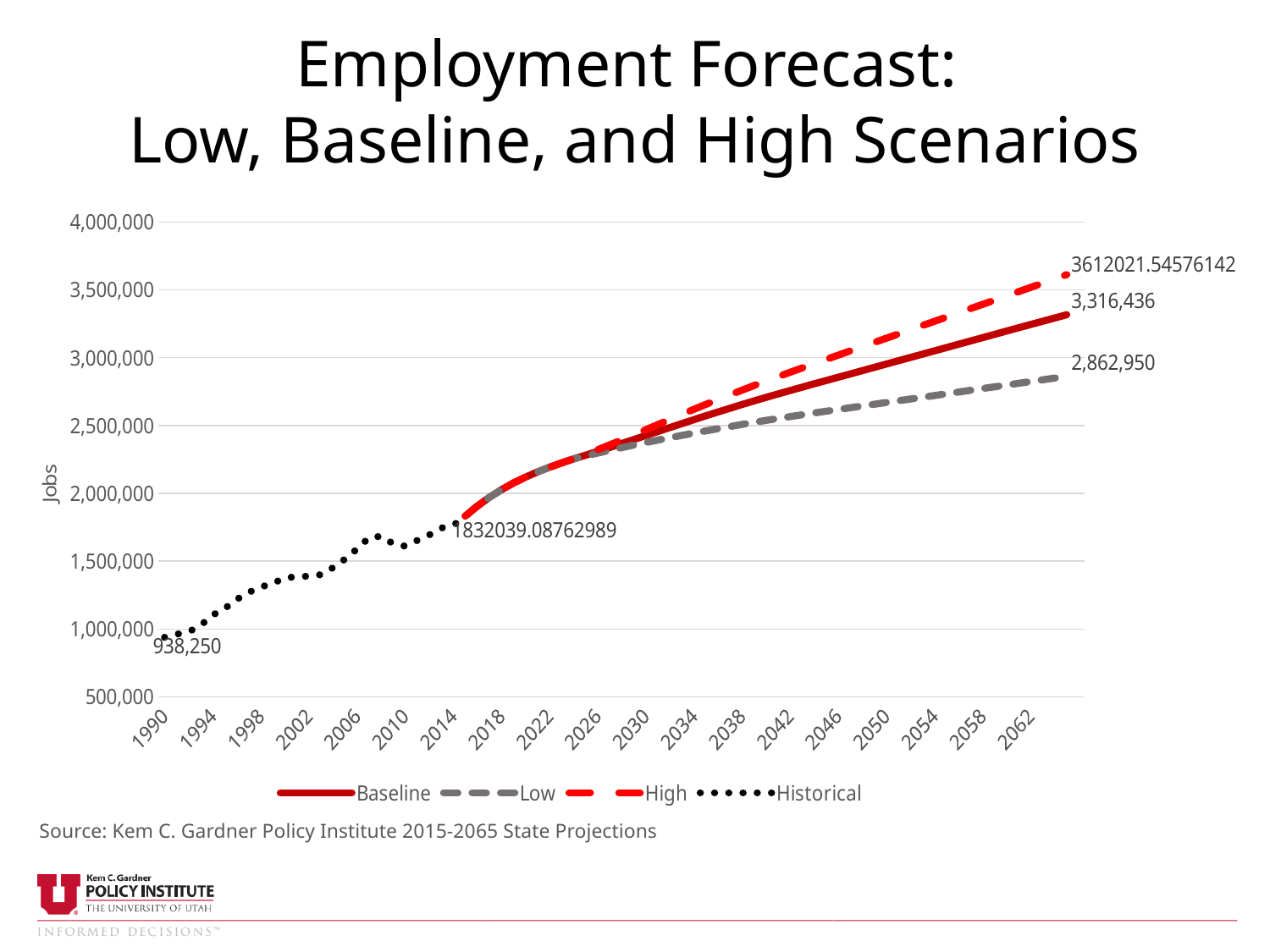
Do the forecast series rise or fall from 2018 to 2062? rise What kind of chart is shown on the slide? line chart What is the difference between the labelled end values of the Baseline and Low series? 453,486 At the end of the forecast, which is larger: the Baseline value or the Low value? Baseline Which scenario series ends with the highest value? High What is the label on the vertical axis? Jobs What is the labelled end value of the High series? 3612021.54576142 What is the labelled value of the Historical series at the start of the chart in 1990? 938,250 Is the value of the Low series in 2050 greater or less than 2,500,000? greater What is the labelled end value of the Low series? 2,862,950 What is the labelled end value of the Baseline series? 3,316,436 How many series does the legend list? 4